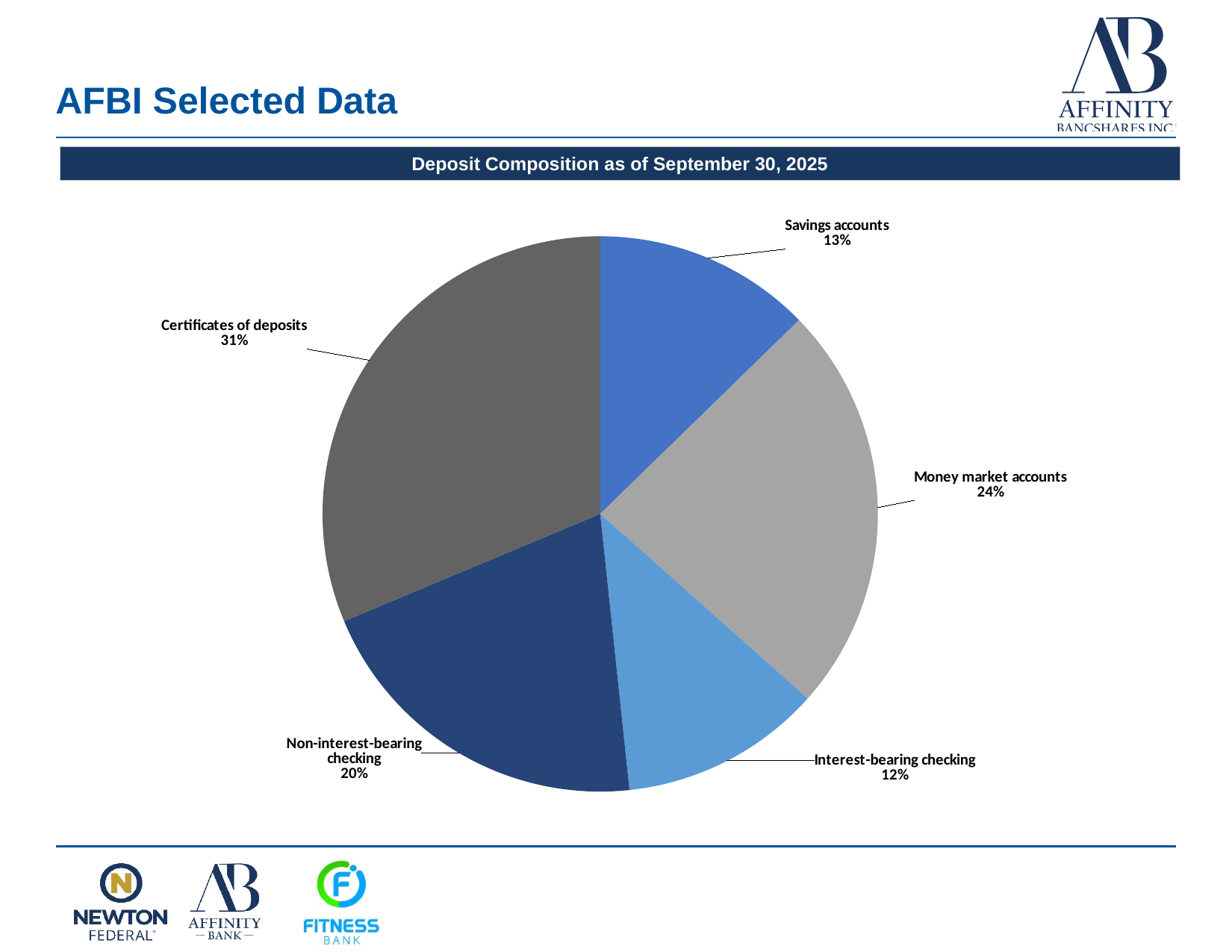
What share of deposits is in savings accounts? 13% Which deposit category has the largest share? Certificates of deposits What is the title of the chart? Deposit Composition as of September 30, 2025 What share of deposits is in money market accounts? 24% What share of deposits is in non-interest-bearing checking? 20% How many deposit categories are shown in the pie chart? 5 What kind of chart is shown on the slide? Pie chart What is the difference in percentage points between certificates of deposits and money market accounts? 7 percentage points Which deposit category has the smallest share? Interest-bearing checking Which is larger, the share for non-interest-bearing checking or the share for savings accounts? Non-interest-bearing checking